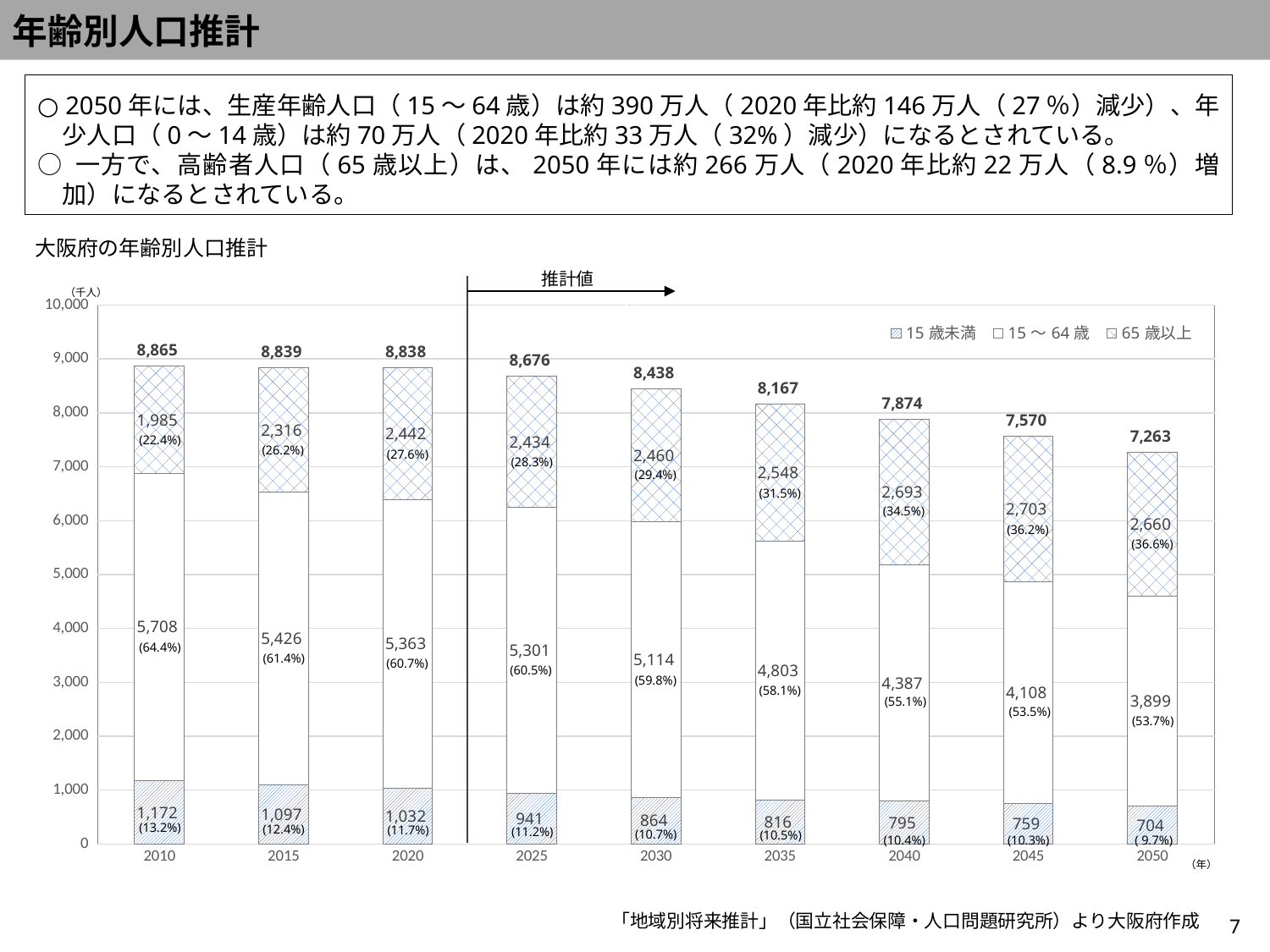
How many series does the legend list? 3 How many years (bars) are plotted on the chart? 9 What is the total population (千人) shown for 2050? 7,263 What percentage share is shown for the 15歳未満 group in 2010? 13.2% What is the value for the 15～64歳 series in 2020? 5,363 Which year has the highest total population? 2010 What is the difference between the total population in 2020 and in 2050? 1,575 Which is larger: the 65歳以上 value in 2045 or in 2050? 2045 What is the value for the 65歳以上 series in 2035? 2,548 Which year has the lowest value for the 15歳未満 series? 2050 Does the 15～64歳 series rise or fall from 2010 to 2050? Fall What kind of chart is shown? Stacked bar chart